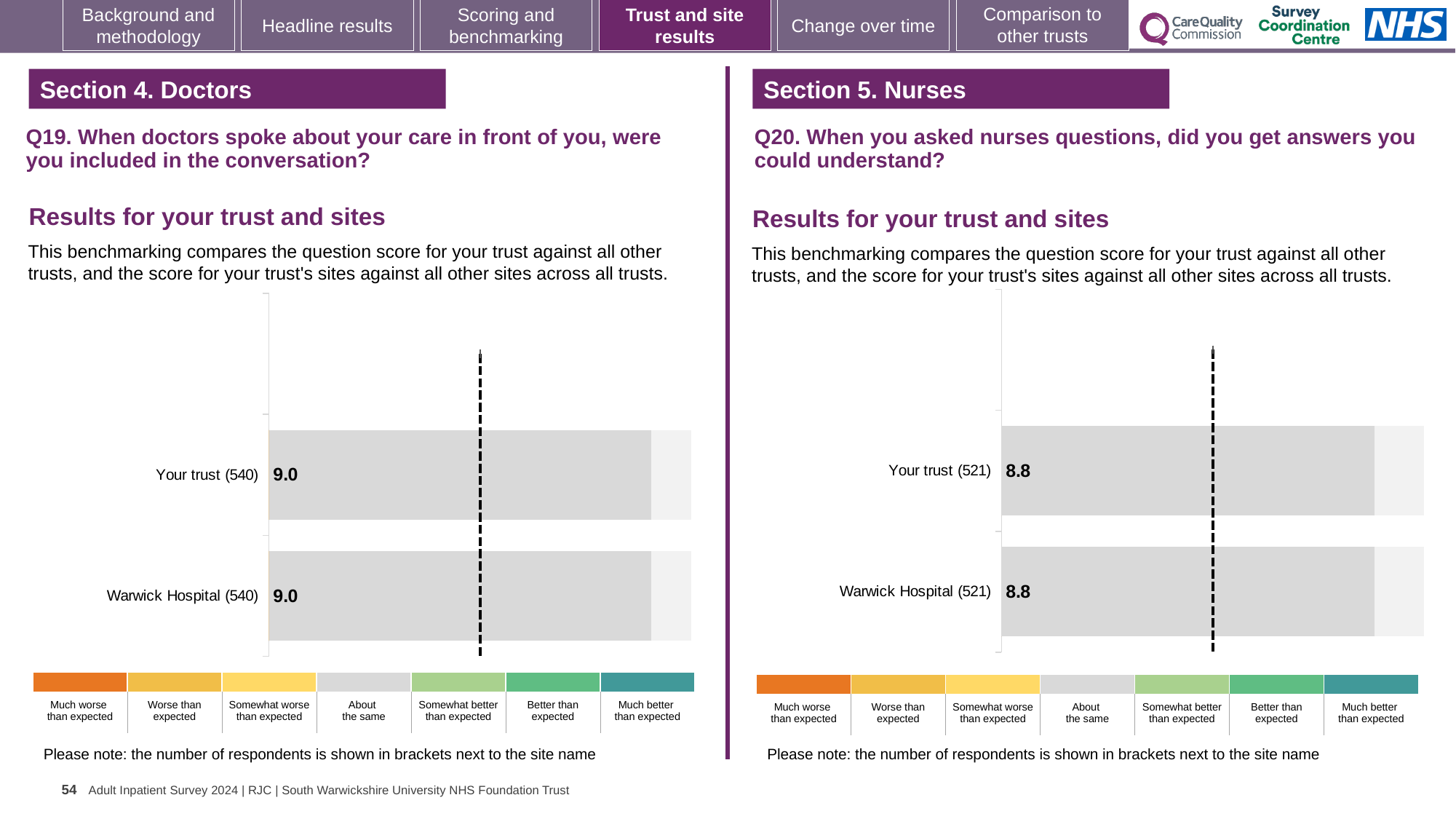
Is the Your trust score on the Q19 chart (left) larger than the Your trust score on the Q20 chart (right)? Yes On the Q20 chart (right), what is the score for Warwick Hospital? 8.8 On the Q19 chart (left), what is the score for Warwick Hospital? 9.0 On the Q20 chart (right), how many respondents are shown in brackets next to Warwick Hospital? 521 How many bars are plotted on the Q20 chart (right)? 2 On the Q20 chart (right), what is the score for Your trust? 8.8 On the Q20 chart (right), what is the difference between the Your trust score and the Warwick Hospital score? 0.0 On the Q19 chart (left), what is the score for Your trust? 9.0 On the Q19 chart (left), what is the difference between the Your trust score and the Warwick Hospital score? 0.0 What kind of chart is used for the Q20 results (right)? Bar chart How many bars are plotted on the Q19 chart (left)? 2 On the Q19 chart (left), how many respondents are shown in brackets next to Your trust? 540